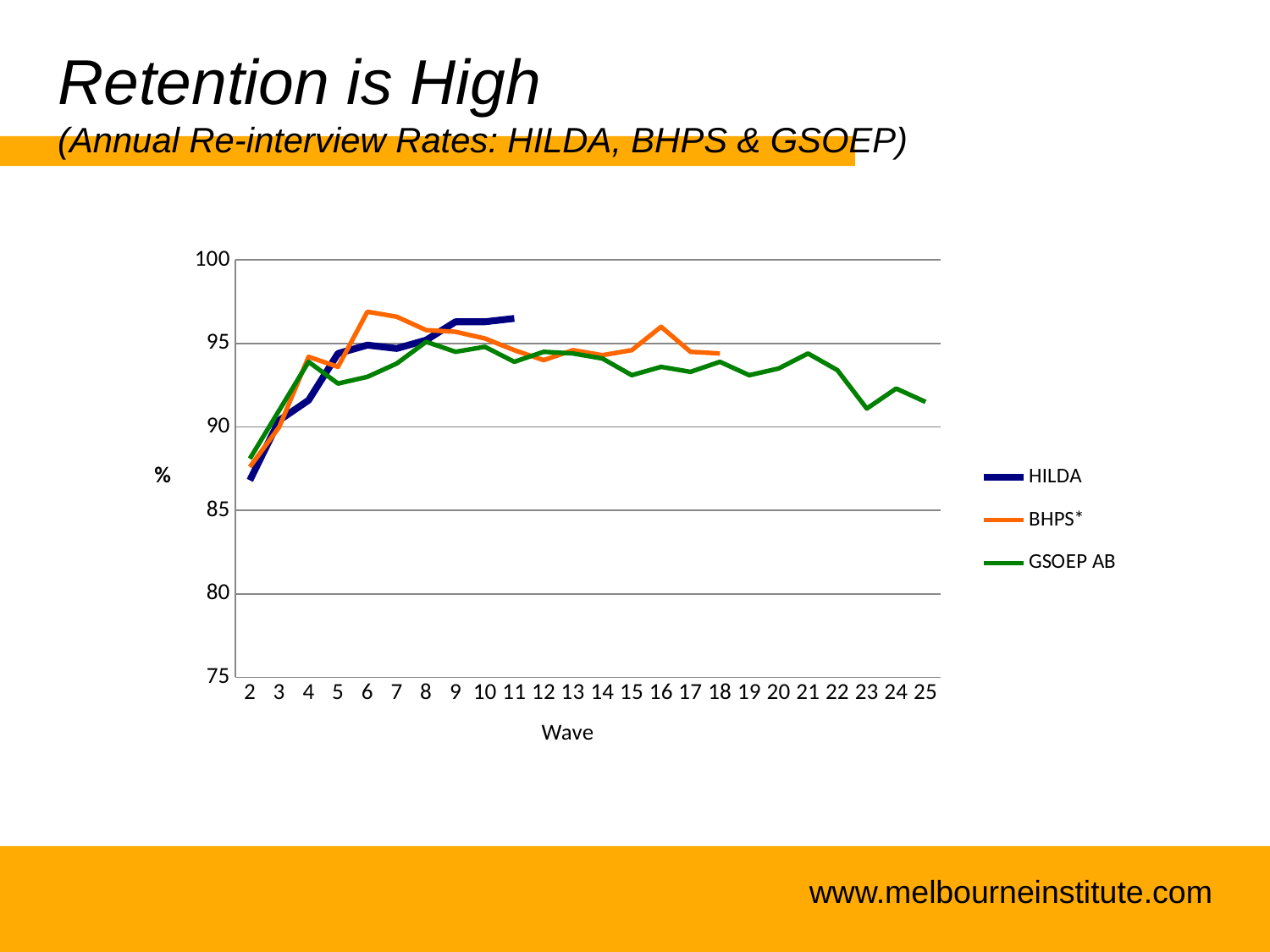
What kind of chart is shown on the slide? line chart What is the label of the x axis? Wave Is the value for HILDA at wave 2 greater or less than 90? less Which series extends all the way to wave 25? GSOEP AB At wave 6, which series has the higher value, BHPS* or GSOEP AB? BHPS* Is the value for BHPS* at wave 6 greater or less than 95? greater Is the value for GSOEP AB at wave 25 greater or less than 95? less How many series does the legend list? 3 Does the HILDA line rise or fall from wave 2 to wave 6? rise How many waves are labelled on the x axis? 24 Which series are listed in the legend? HILDA, BHPS*, GSOEP AB